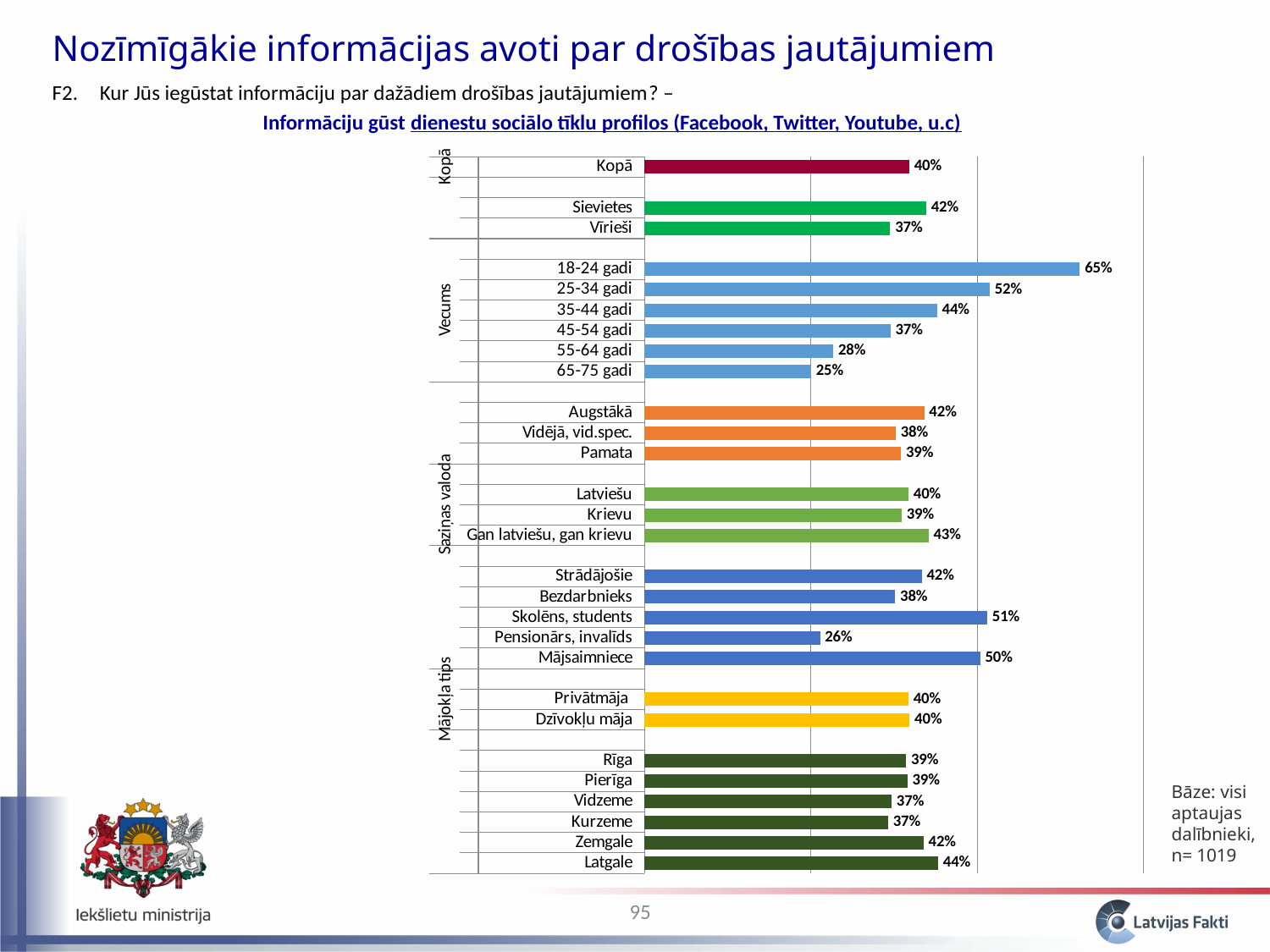
What is the difference between the values for Sievietes and Vīrieši? 5% Which is larger, the value for Skolēns, students or the value for Mājsaimniece? Skolēns, students What is the value for 18-24 gadi? 65% What is the value for Latgale? 44% How many age groups (Vecums) are shown on the chart? 6 What is the difference between the values for 18-24 gadi and 65-75 gadi? 40% Which category has the highest value on the chart? 18-24 gadi Do the values fall or rise as age increases from 18-24 gadi to 65-75 gadi? Fall What is the value for Kopā? 40% What kind of chart is shown on the slide? Bar chart Which category has the lowest value on the chart? 65-75 gadi What is the value for Pensionārs, invalīds? 26%